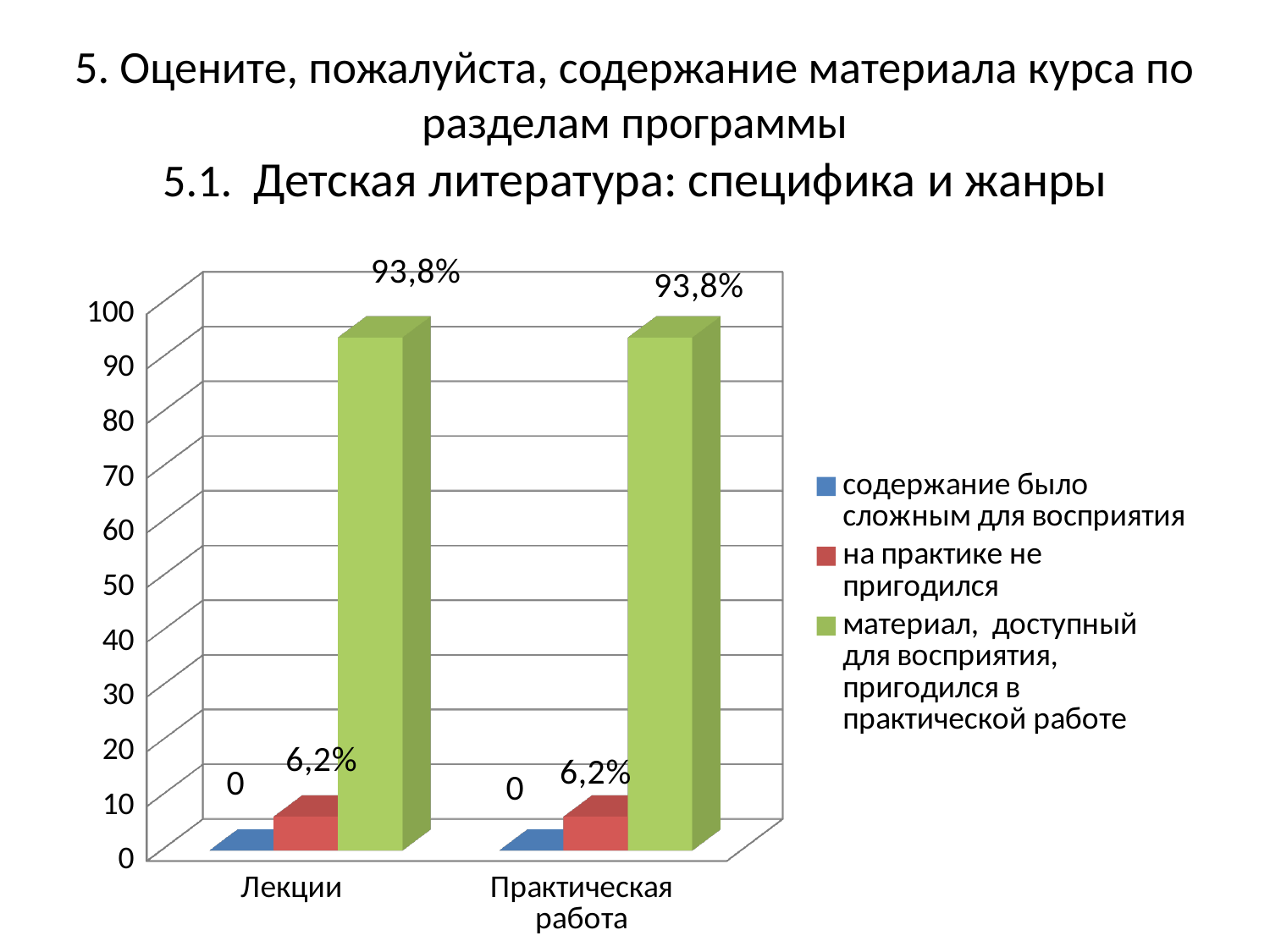
How many categories are shown on the x axis of the chart? 2 Is the value for "материал, доступный для восприятия, пригодился в практической работе" in the "Лекции" category greater or less than 90? greater What is the value for "материал, доступный для восприятия, пригодился в практической работе" in the "Лекции" category? 93,8% Which series has the lowest value in the "Лекции" category? содержание было сложным для восприятия What is the value for "на практике не пригодился" in the "Практическая работа" category? 6,2% What kind of chart is shown on the slide? bar chart What is the value for "содержание было сложным для восприятия" in the "Лекции" category? 0 What is the difference between the "материал, доступный для восприятия, пригодился в практической работе" value and the "на практике не пригодился" value in the "Лекции" category? 87,6% Which is larger in the "Практическая работа" category: "на практике не пригодился" or "содержание было сложным для восприятия"? на практике не пригодился Which series has the highest value in the "Практическая работа" category? материал, доступный для восприятия, пригодился в практической работе What colour are the bars for the series "на практике не пригодился"? red How many series does the chart legend list? 3